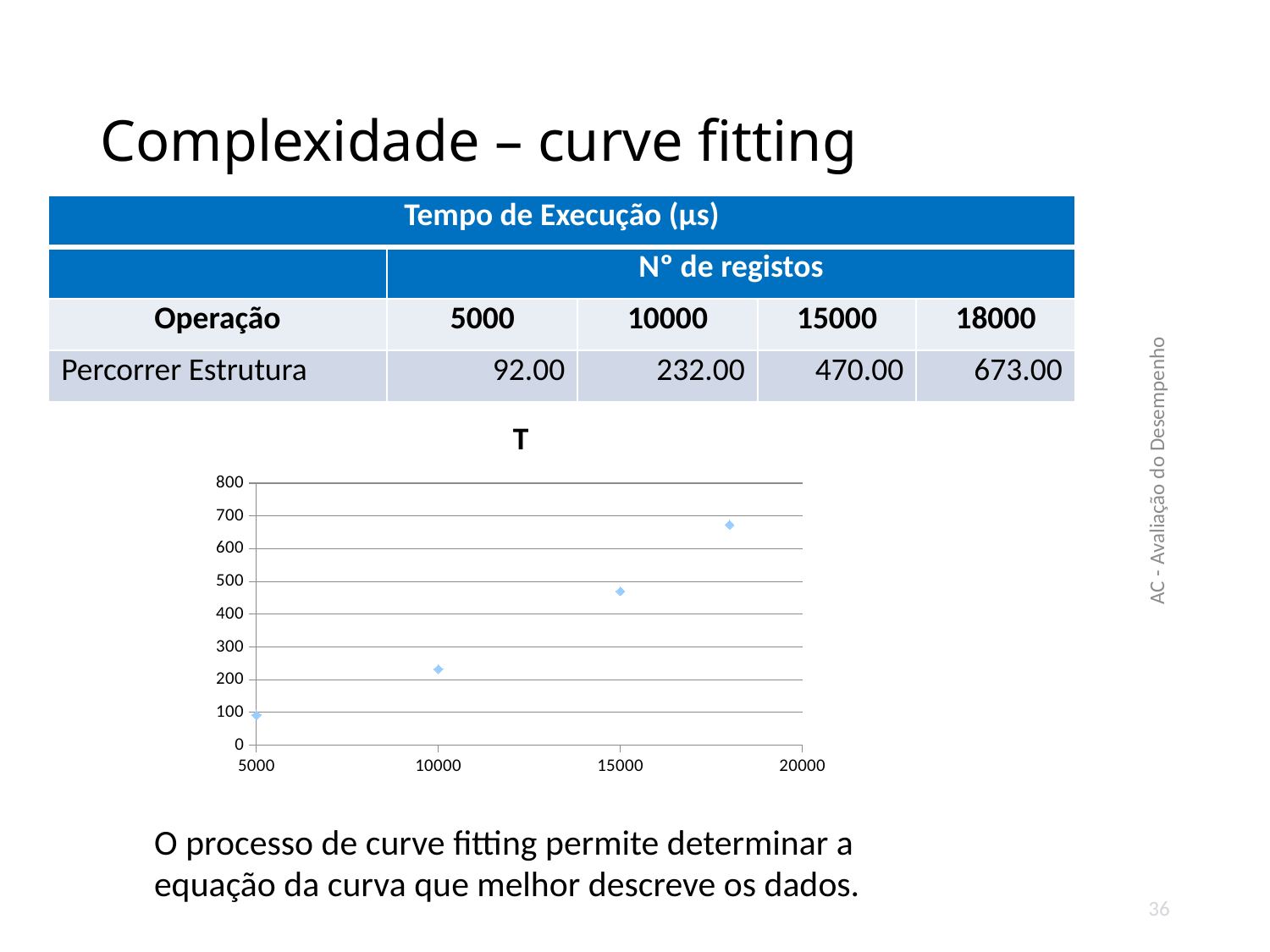
What kind of chart is shown on the slide? scatter chart What is the difference between the execution times at 18000 and 5000 records, as given in the table? 581.00 Is the plotted value at 10000 records greater or less than 300? less Is the plotted value at 15000 records greater or less than 400? greater What is the execution time for Percorrer Estrutura at 15000 records, as given in the table? 470.00 Is the plotted value at 18000 records greater or less than 600? greater What is the title of the chart? T Do the plotted values rise or fall as the number of records increases along the x axis? rise At which x value is the lowest point plotted? 5000 At which x value is the highest point plotted? 18000 How many data points are plotted in the chart? 4 Which is larger, the plotted value at 10000 records or at 15000 records? 15000 records